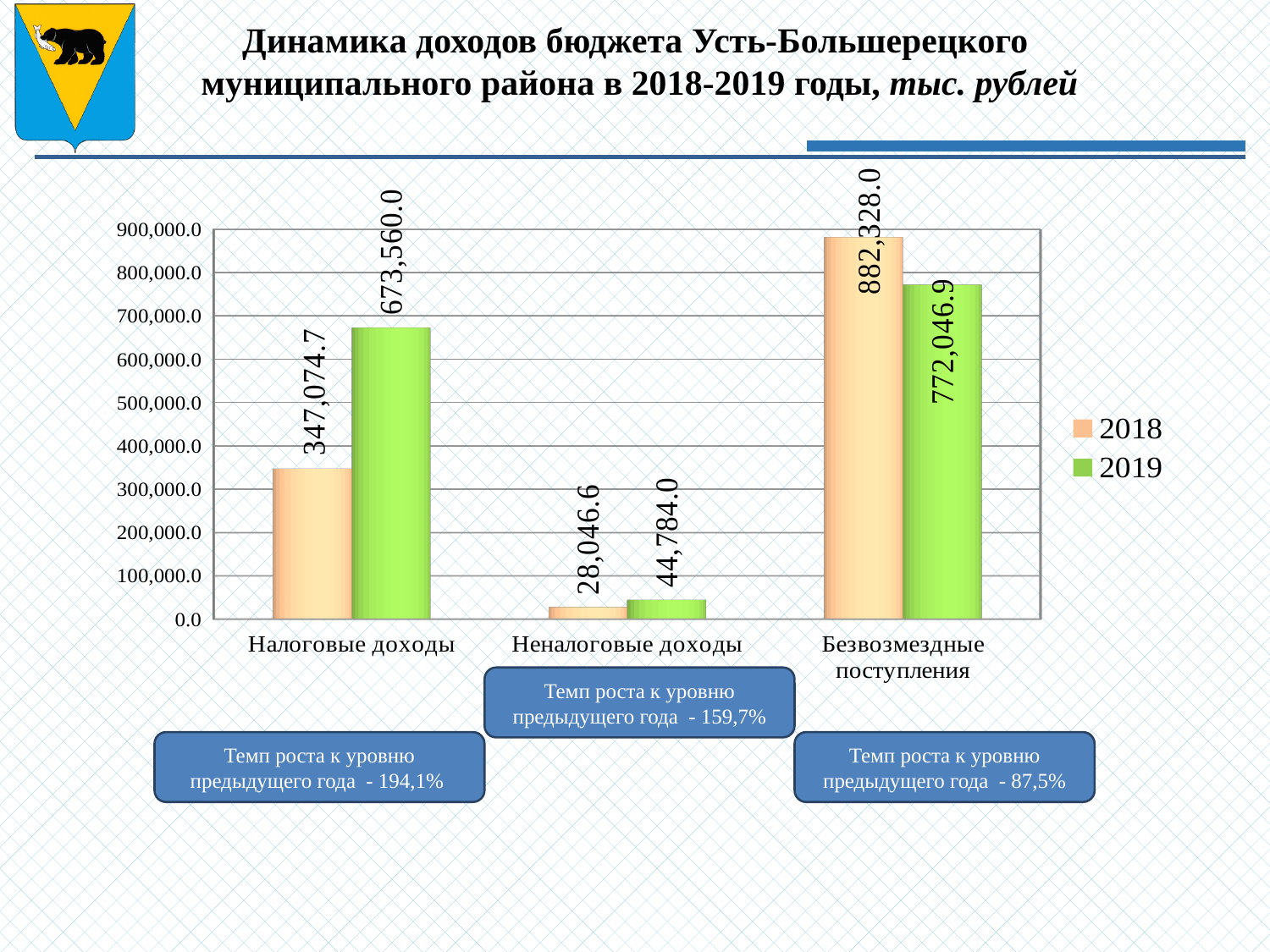
Which colour represents the 2019 series in the legend? green Which category has the lowest 2019 value? Неналоговые доходы Which category has the highest 2018 value? Безвозмездные поступления How many series does the legend list? 2 What is the difference between the 2018 and 2019 values for Безвозмездные поступления? 110,281.1 What kind of chart is shown on the slide? bar chart What is the 2019 value for Безвозмездные поступления? 772,046.9 For Безвозмездные поступления, which year has the larger value, 2018 or 2019? 2018 What is the 2018 value for Налоговые доходы? 347,074.7 How many categories are shown on the x axis? 3 What is the 2019 value for Неналоговые доходы? 44,784.0 What is the difference between the 2019 and 2018 values for Налоговые доходы? 326,485.3